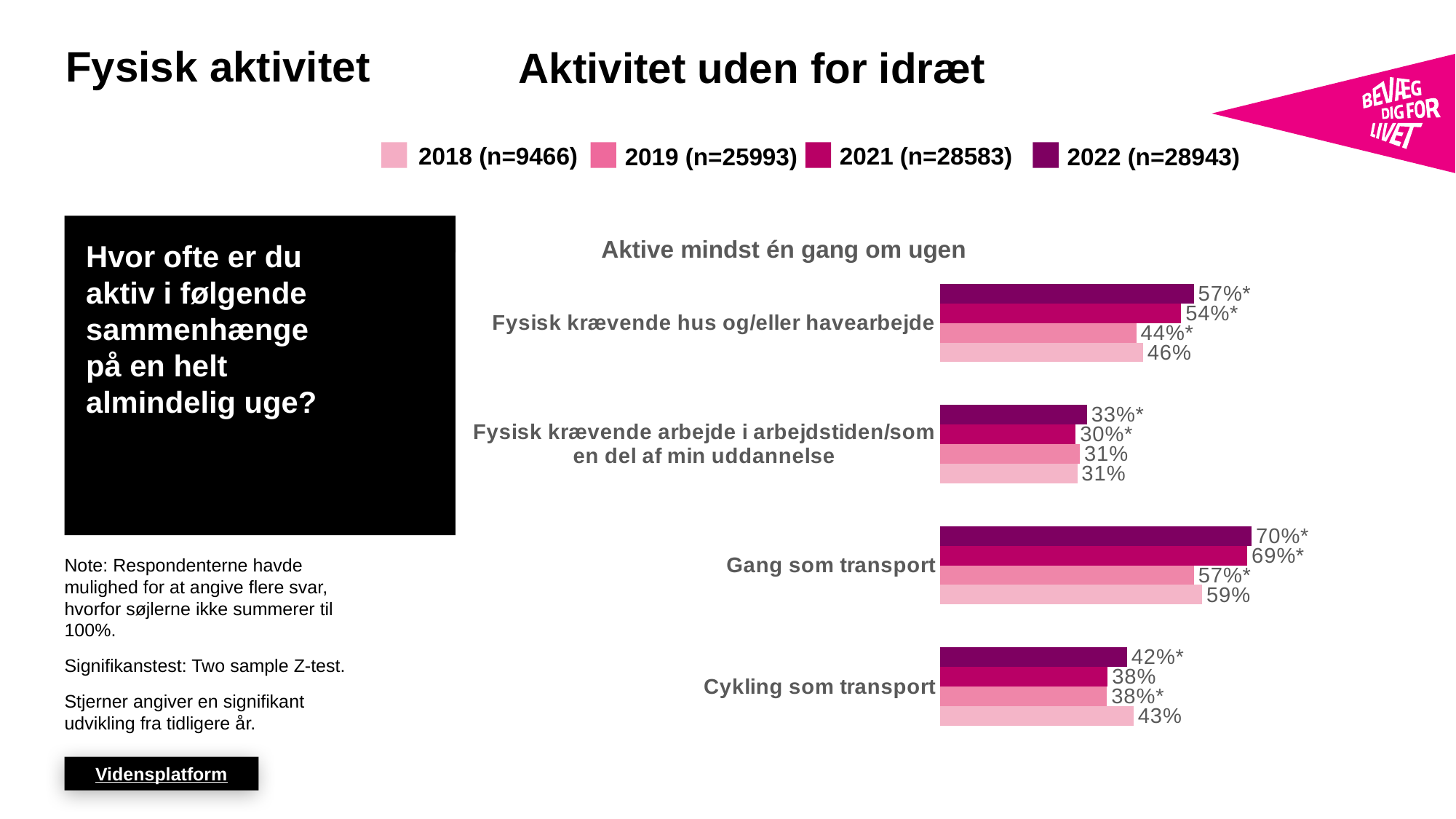
Which is larger for 'Fysisk krævende hus og/eller havearbejde': the 2022 value or the 2018 value? 2022 What is the 2018 value for 'Fysisk krævende hus og/eller havearbejde'? 46% What type of chart is shown on the slide? bar chart Which category has the lowest 2018 value? Fysisk krævende arbejde i arbejdstiden/som en del af min uddannelse How many series does the legend list? 4 What is the 2019 value for 'Fysisk krævende arbejde i arbejdstiden/som en del af min uddannelse'? 31% How many categories are shown in the chart? 4 What is the 2021 value for 'Cykling som transport'? 38% What is the 2022 value for 'Gang som transport'? 70%* What is the title of the chart? Aktive mindst én gang om ugen What is the difference between the 2022 and 2019 values for 'Gang som transport'? 13 percentage points Which category has the highest 2022 value? Gang som transport